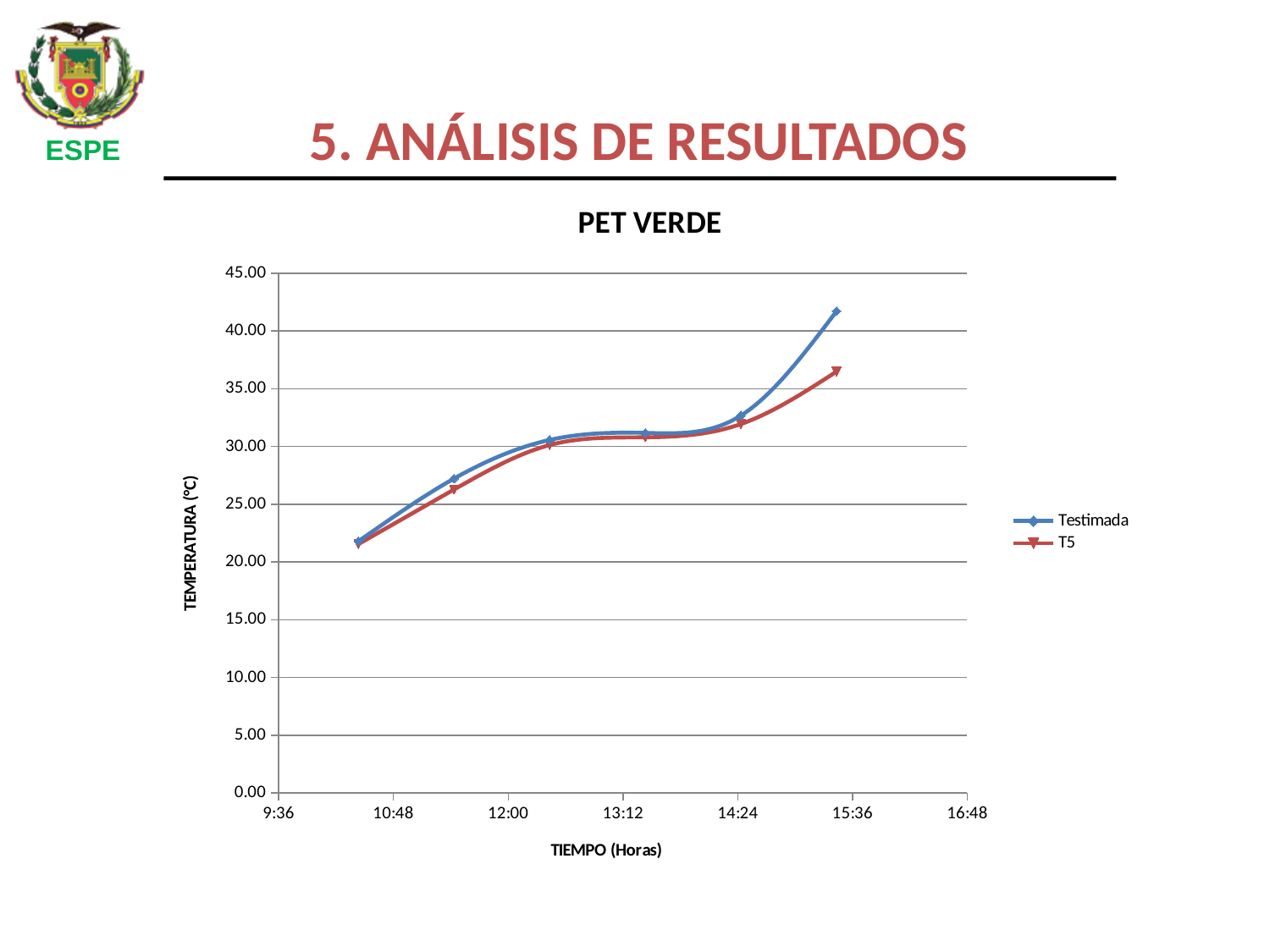
Do the temperature values for the Testimada series rise or fall along the x axis? rise How many series does the legend list? 2 At the last time point, which series has the higher temperature, Testimada or T5? Testimada What is the title of the chart? PET VERDE What kind of chart is shown on the slide? line chart Is the final (rightmost) value of the T5 series greater or less than 40.00? less Is the final (rightmost) value of the T5 series greater or less than 35.00? greater How many data points are plotted for the Testimada series? 6 Which series reaches the highest temperature on the chart? Testimada Do the temperature values for the T5 series rise or fall along the x axis? rise Is the final (rightmost) value of the Testimada series greater or less than 40.00? greater What are the names of the two series in the legend? Testimada and T5